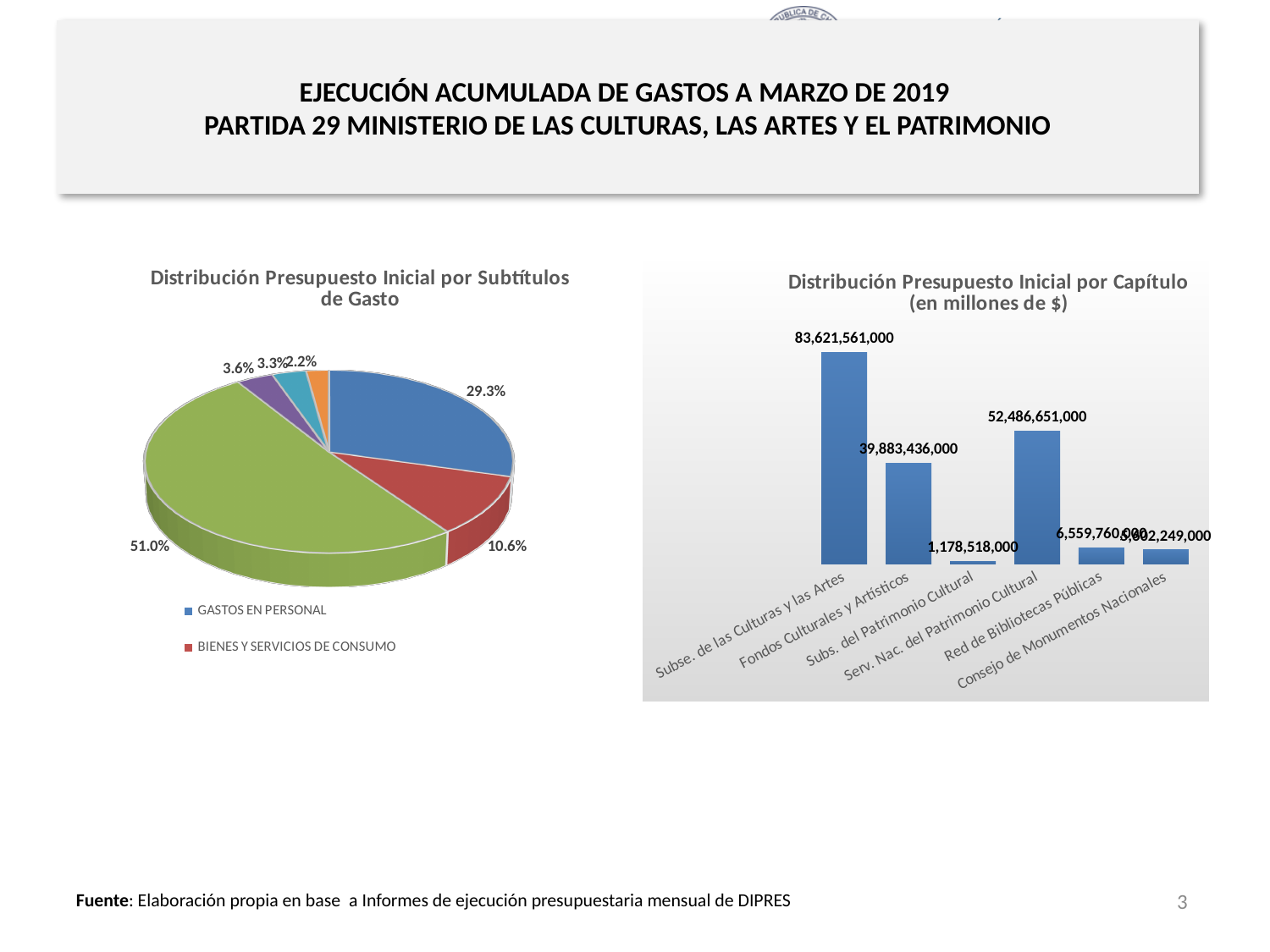
In the chart 'Distribución Presupuesto Inicial por Capítulo', what is the value for Subse. de las Culturas y las Artes? 83,621,561,000 In the chart 'Distribución Presupuesto Inicial por Capítulo', which category has the lowest value? Subs. del Patrimonio Cultural In the pie chart on the left, which is larger: GASTOS EN PERSONAL or BIENES Y SERVICIOS DE CONSUMO? GASTOS EN PERSONAL What kind of chart is 'Distribución Presupuesto Inicial por Capítulo' on the right? bar chart In the pie chart on the left, what is the percentage of the largest slice? 51.0% In the pie chart on the left, how many slices are there? 6 In the pie chart on the left, what is the percentage of the smallest slice? 2.2% In the chart 'Distribución Presupuesto Inicial por Capítulo', what is the value for Serv. Nac. del Patrimonio Cultural? 52,486,651,000 In the pie chart 'Distribución Presupuesto Inicial por Subtítulos de Gasto', what share does GASTOS EN PERSONAL have? 29.3% In the chart 'Distribución Presupuesto Inicial por Capítulo', which category has the highest value? Subse. de las Culturas y las Artes In the pie chart on the left, what is the difference in percentage points between GASTOS EN PERSONAL and BIENES Y SERVICIOS DE CONSUMO? 18.7 percentage points In the pie chart 'Distribución Presupuesto Inicial por Subtítulos de Gasto', what share does BIENES Y SERVICIOS DE CONSUMO have? 10.6%